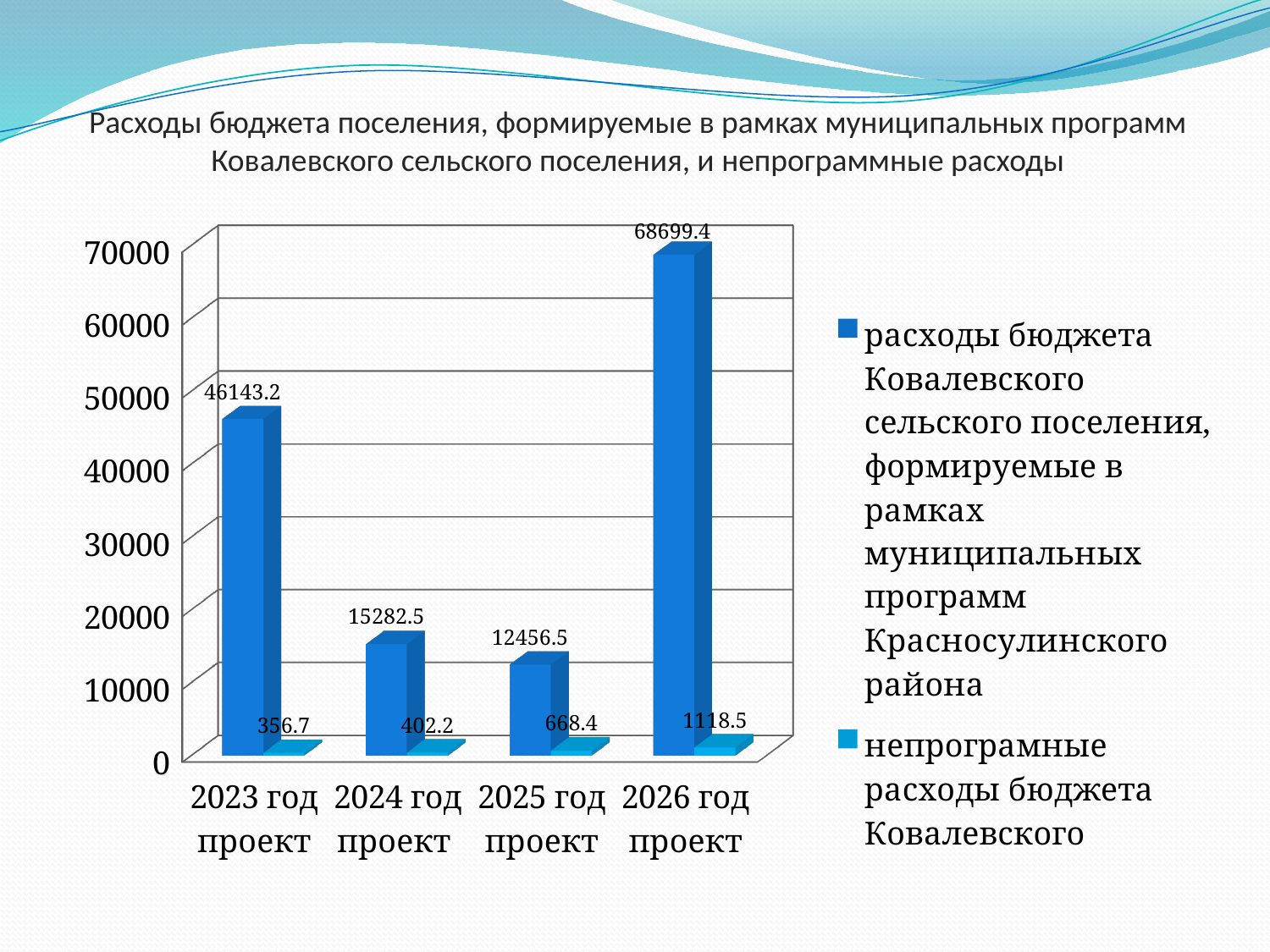
What is the value of the program expenses (расходы бюджета, формируемые в рамках муниципальных программ) for 2023 год проект? 46143.2 What kind of chart is shown on the slide? Bar chart What is the value of the non-program expenses (непрограмные расходы) for 2025 год проект? 668.4 How many series does the legend list? 2 Which year has the lowest program expenses? 2025 год проект Which year has the lowest non-program expenses? 2023 год проект What is the value of the non-program expenses for 2024 год проект? 402.2 What is the value of the program expenses for 2026 год проект? 68699.4 Which is larger: the program expenses for 2024 год проект or for 2025 год проект? 2024 год проект What is the difference between the program expenses for 2026 год проект and 2023 год проект? 22556.2 Which year has the highest program expenses? 2026 год проект How many year categories are shown on the x axis? 4